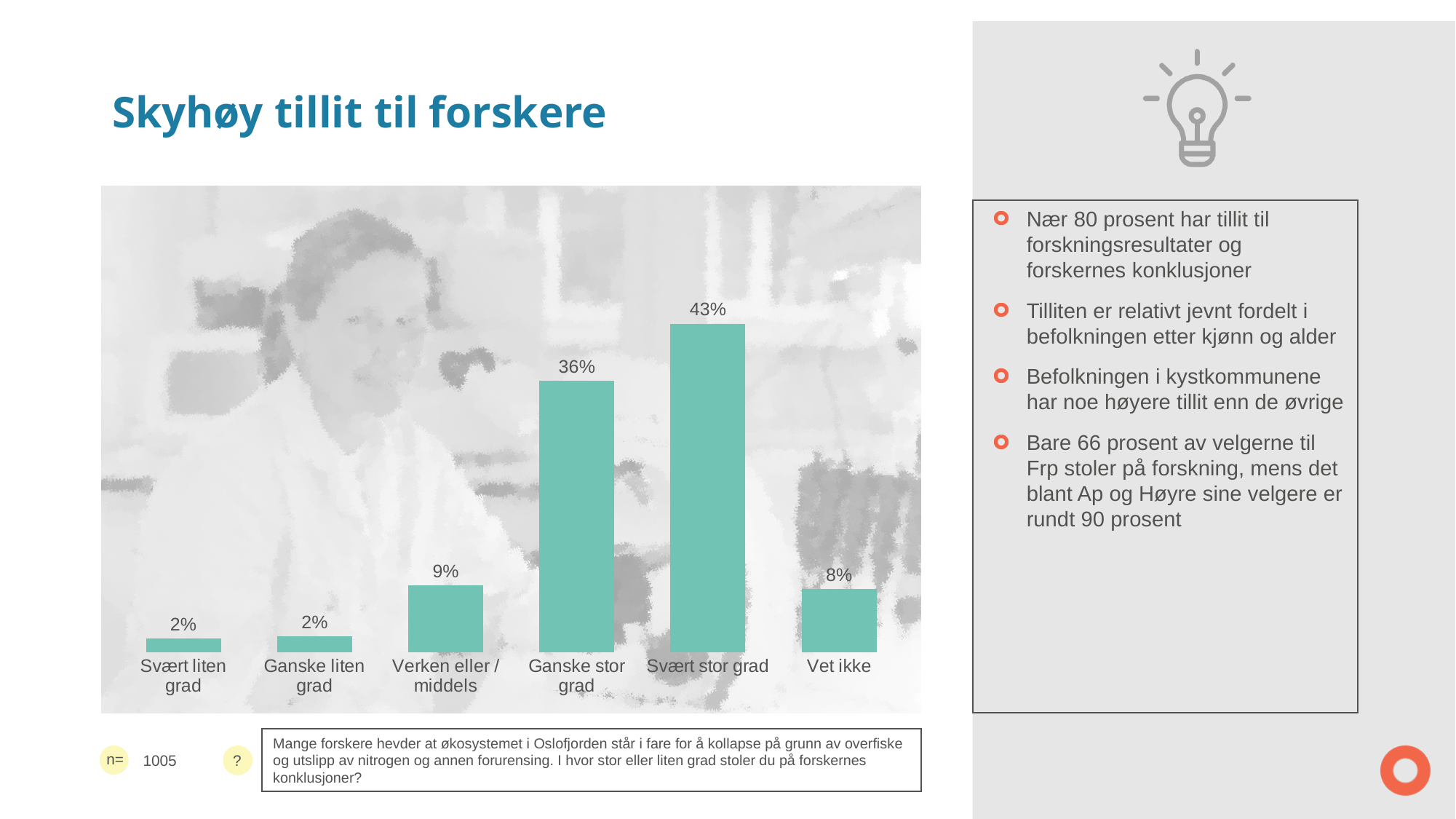
What is the combined value of "Ganske stor grad" and "Svært stor grad"? 79% What is the value for "Ganske liten grad"? 2% What is the value for "Vet ikke"? 8% What is the title of the slide containing the chart? Skyhøy tillit til forskere How many categories are shown on the x axis of the chart? 6 Which category has the highest value? Svært stor grad What is the value for "Verken eller / middels"? 9% What is the difference between the values for "Svært stor grad" and "Ganske stor grad"? 7% What is the value for "Svært stor grad"? 43% What is the value for "Ganske stor grad"? 36% What kind of chart is shown on the slide? Bar chart Which is larger, the value for "Verken eller / middels" or the value for "Vet ikke"? Verken eller / middels